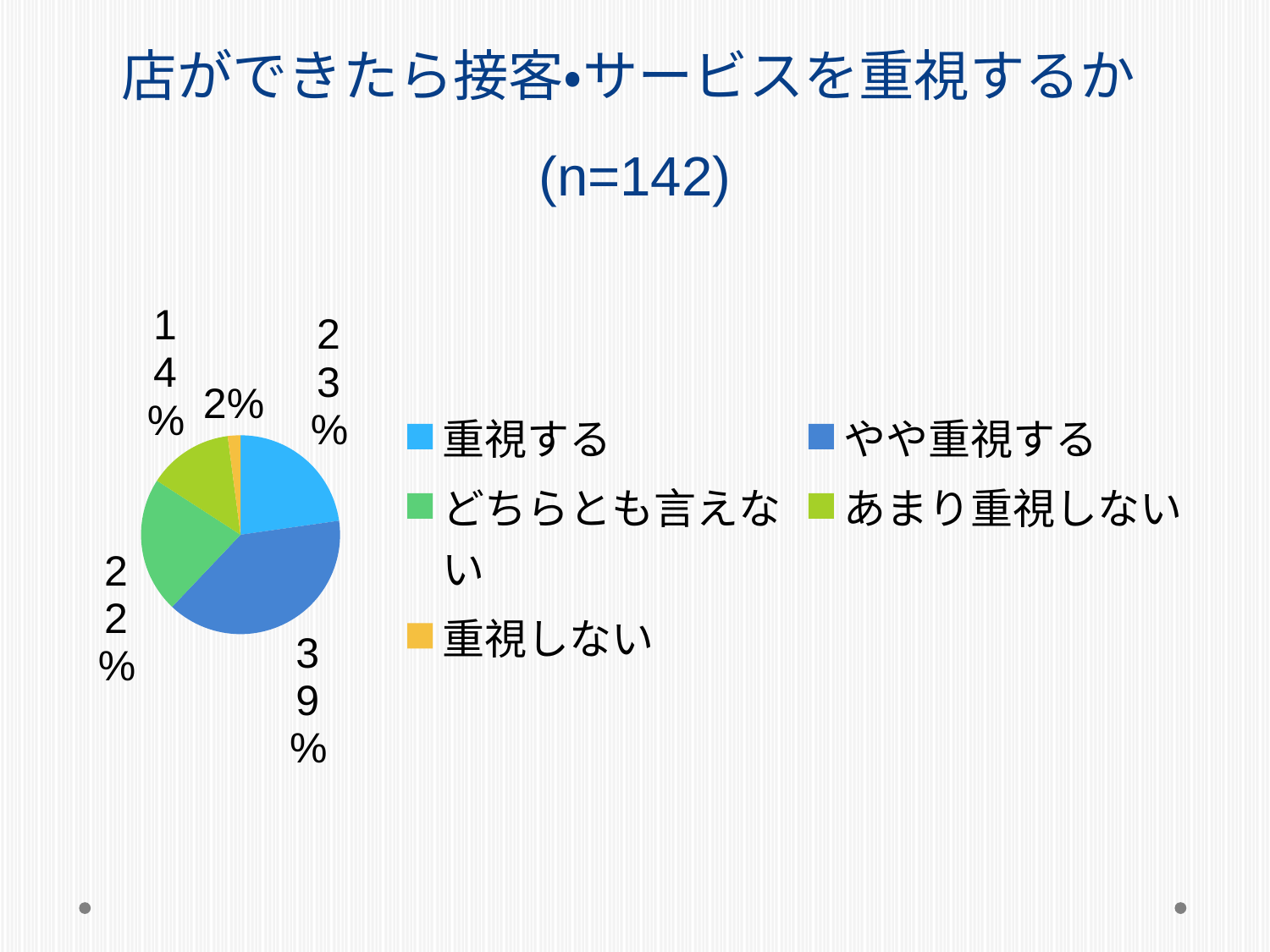
Which response has the smallest share of the pie? 重視しない What percentage of respondents answered 重視する? 23% Which response has the largest share of the pie? やや重視する What is the difference in percentage points between やや重視する and 重視する? 16 What percentage of respondents answered 重視しない? 2% How many categories does the pie chart have? 5 What percentage of respondents answered どちらとも言えない? 22% What percentage of respondents answered やや重視する? 39% What is the sample size (n) shown in the chart title? 142 Which is larger, the share for あまり重視しない or the share for どちらとも言えない? どちらとも言えない What kind of chart is shown on the slide? Pie chart What percentage of respondents answered あまり重視しない? 14%